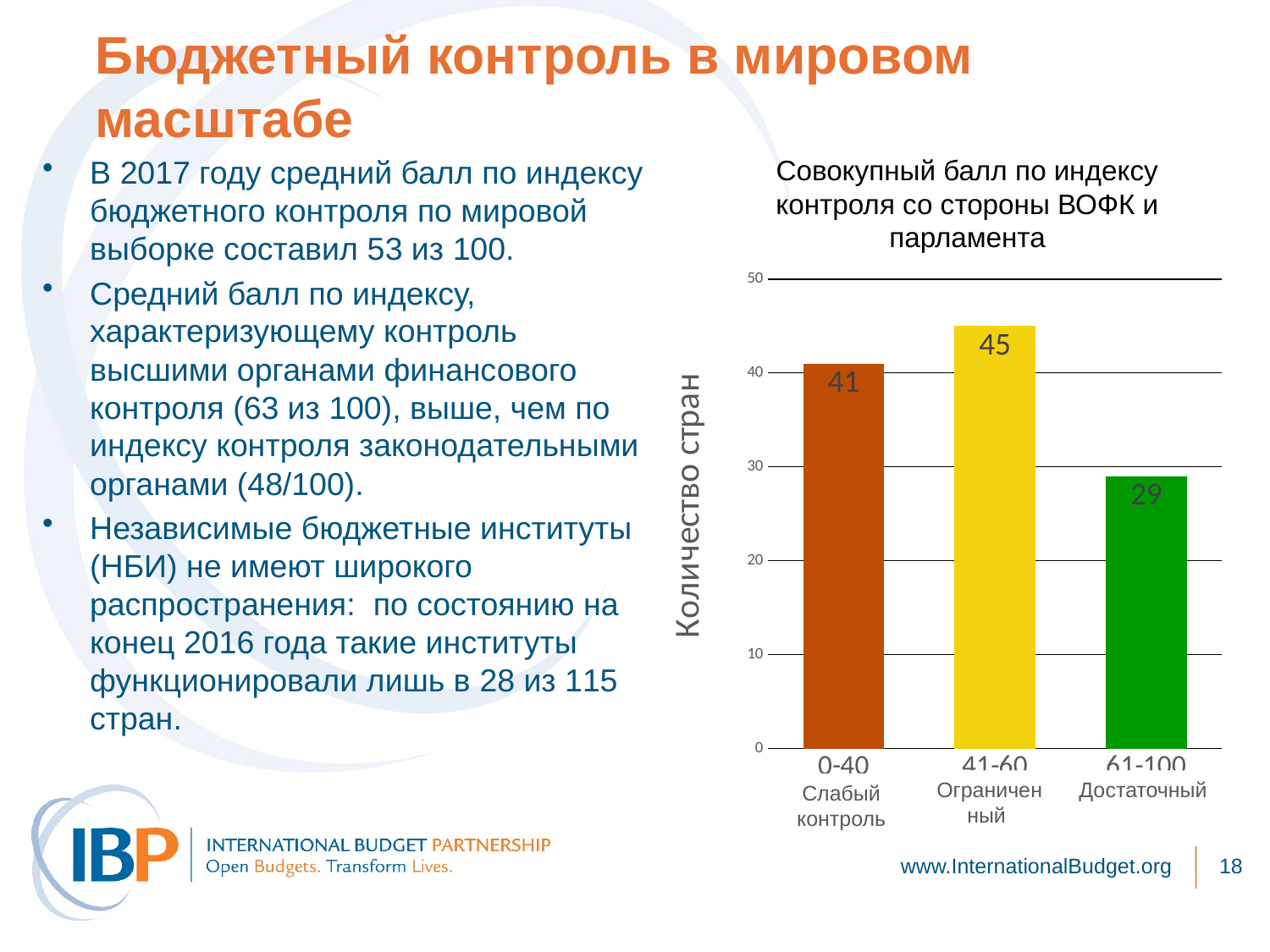
Is the value for 61-100 greater or less than 30? less Which is larger, the value for 0-40 or the value for 61-100? 0-40 What is the difference between the values for 41-60 and 61-100? 16 Which category has the highest number of countries? 41-60 (Ограниченный) What is the label of the vertical axis of the chart? Количество стран How many categories are shown in the chart? 3 What kind of chart is shown on the slide? bar chart What is the value for the 41-60 (Ограниченный) category? 45 What is the value for the 0-40 (Слабый контроль) category? 41 What is the value for the 61-100 (Достаточный) category? 29 Which category has the lowest number of countries? 61-100 (Достаточный) What is the difference between the values for 41-60 and 0-40? 4